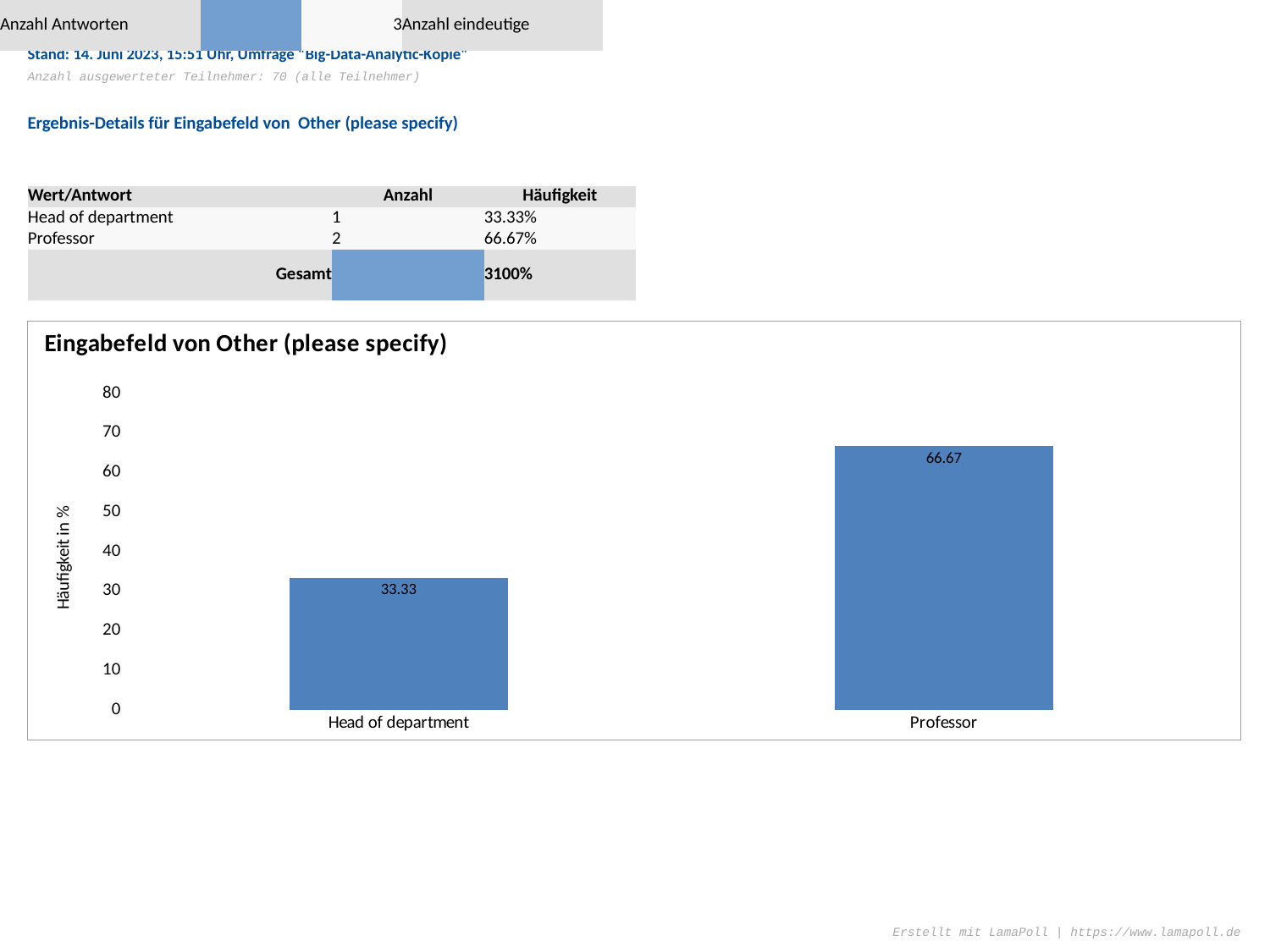
What is the title of the chart? Eingabefeld von Other (please specify) What is the label of the y axis of the chart? Häufigkeit in % What is the value for Head of department in the chart? 33.33 Which category has the lowest value in the chart? Head of department What kind of chart is shown on the slide? bar chart Is the value for Head of department greater or less than 40? less Which category has the highest value in the chart? Professor What is the difference between the values for Professor and Head of department? 33.34 How many categories are shown in the chart? 2 Which is larger, the value for Head of department or the value for Professor? Professor Is the value for Professor greater or less than 60? greater What is the value for Professor in the chart? 66.67